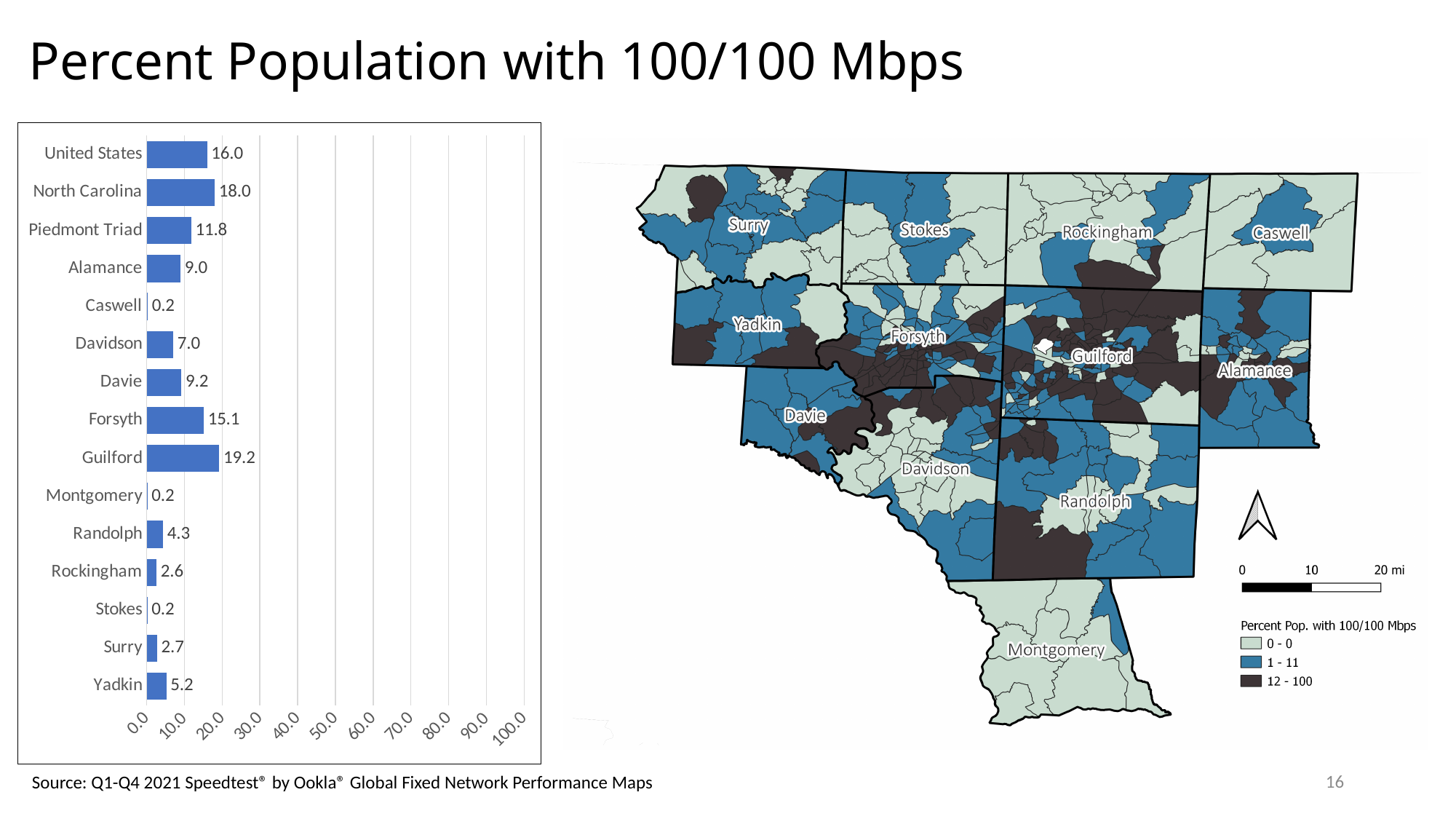
Which has a larger value in the bar chart, Randolph or Rockingham? Randolph What is the difference between the values for Guilford and Forsyth in the bar chart? 4.1 What is the value for Piedmont Triad in the bar chart? 11.8 Which category has the highest value in the bar chart? Guilford How many categories are shown in the bar chart? 15 What is the value for Guilford in the bar chart? 19.2 What kind of chart is shown on the left of the slide? Bar chart Which has a larger value in the bar chart, Forsyth or Piedmont Triad? Forsyth What is the value for North Carolina in the bar chart? 18.0 What is the difference between the values for North Carolina and United States in the bar chart? 2.0 What is the value for Yadkin in the bar chart? 5.2 Is the value for Guilford in the bar chart greater or less than 10.0? greater